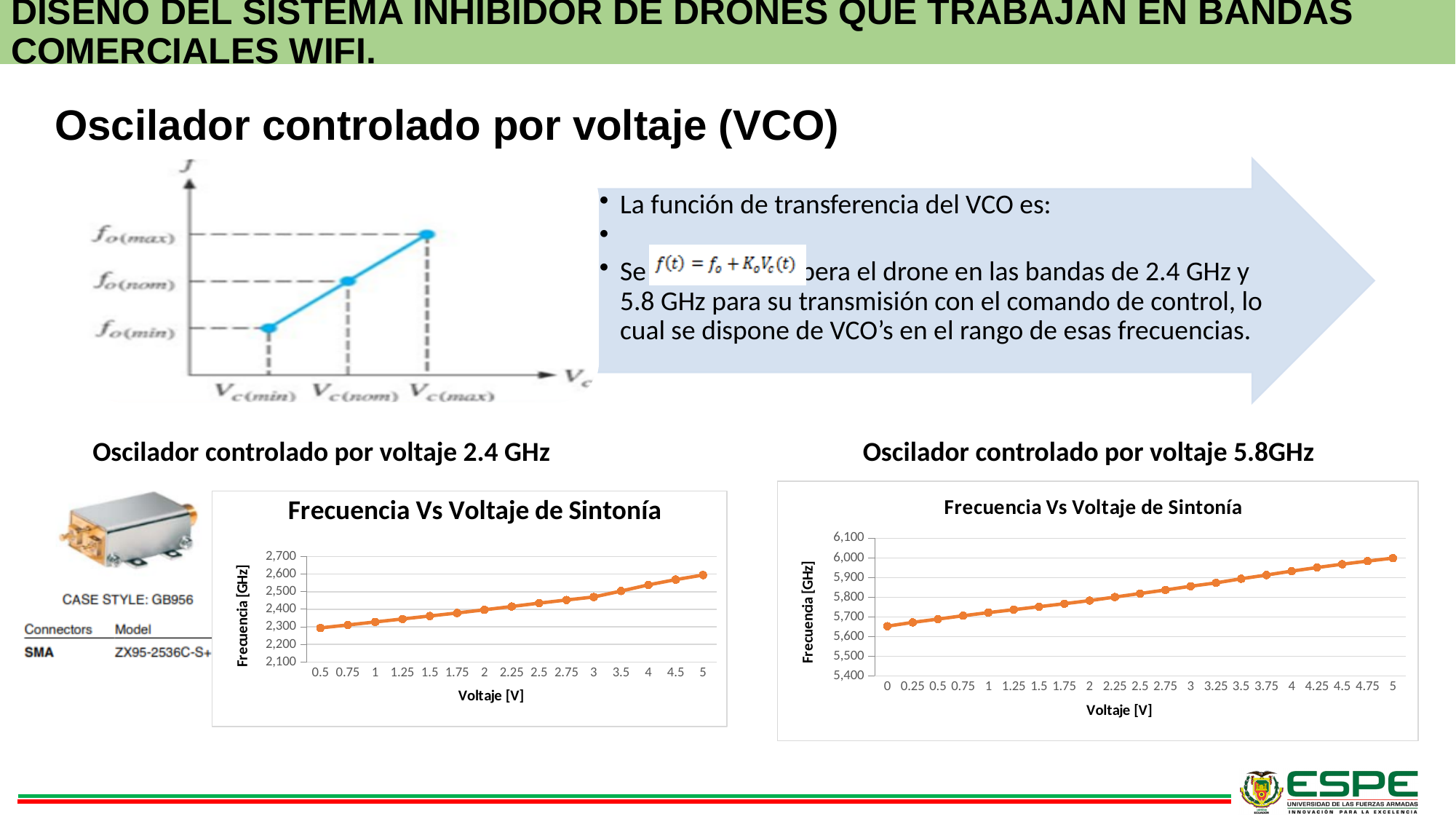
What type of chart is the left chart (Oscilador controlado por voltaje 2.4 GHz)? line chart In the left chart (2.4 GHz), at which voltage is the frequency highest? 5 In the right chart (5.8GHz), does the frequency rise or fall as the voltage increases? rise What type of chart is the right chart (Oscilador controlado por voltaje 5.8GHz)? line chart In the right chart (5.8GHz), at which voltage is the frequency lowest? 0 In the right chart (5.8GHz), is the frequency at 0 V greater or less than 5,600? greater In the left chart (2.4 GHz), does the frequency rise or fall as the voltage increases? rise In the left chart (2.4 GHz), how many voltage points are plotted along the x axis? 15 In the left chart (2.4 GHz), is the frequency at 3 V greater or less than 2,400? greater What is the title of the left chart (2.4 GHz)? Frecuencia Vs Voltaje de Sintonía In the right chart (5.8GHz), how many voltage points are plotted along the x axis? 21 In the right chart (5.8GHz), is the frequency at 3 V greater or less than 5,900? less